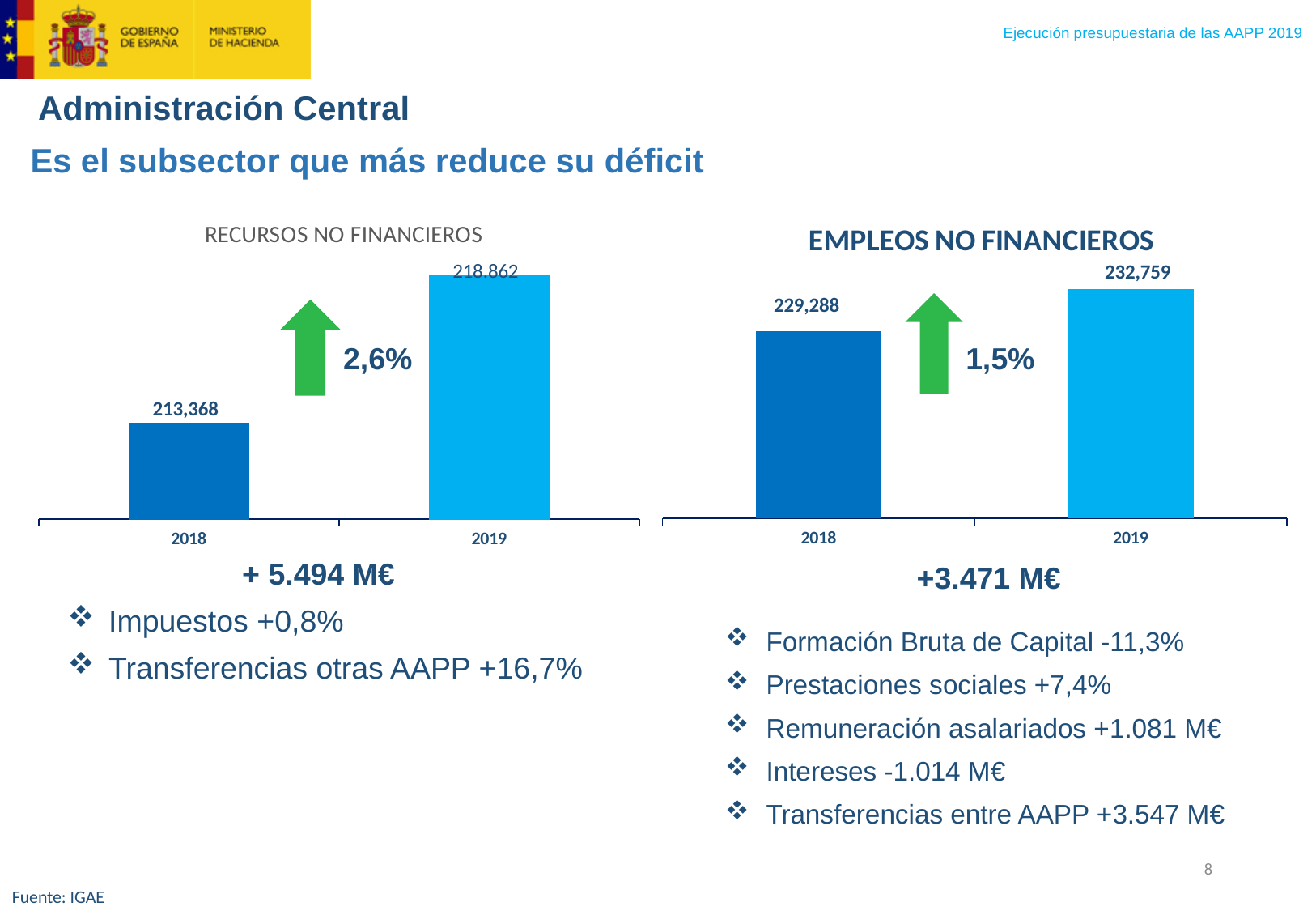
In the RECURSOS NO FINANCIEROS chart, what is the difference between the 2019 and 2018 values? 5,494 In the RECURSOS NO FINANCIEROS chart, do the values rise or fall from 2018 to 2019? rise What type of chart is the EMPLEOS NO FINANCIEROS chart? bar chart In the RECURSOS NO FINANCIEROS chart, what is the value for 2018? 213,368 In the EMPLEOS NO FINANCIEROS chart, what is the value for 2018? 229,288 How many bars are shown in the RECURSOS NO FINANCIEROS chart? 2 In the RECURSOS NO FINANCIEROS chart, what is the value for 2019? 218.862 In the EMPLEOS NO FINANCIEROS chart, what is the difference between the 2019 and 2018 values? 3,471 In the EMPLEOS NO FINANCIEROS chart, is the value for 2019 larger or smaller than the value for 2018? larger In the RECURSOS NO FINANCIEROS chart, which year has the higher value? 2019 In the EMPLEOS NO FINANCIEROS chart, which year has the lower value? 2018 In the EMPLEOS NO FINANCIEROS chart, what is the value for 2019? 232,759